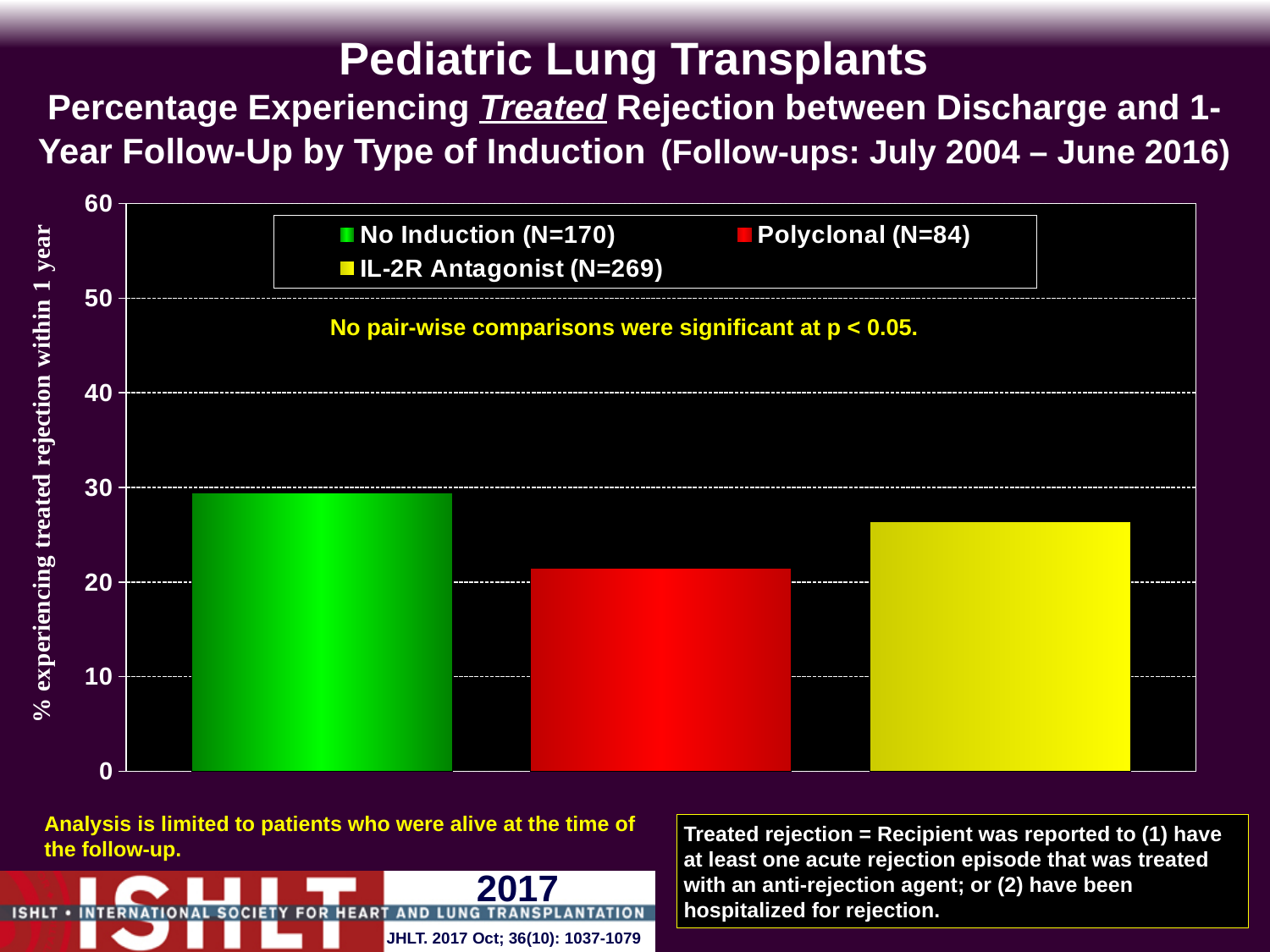
Which induction type has the lowest percentage experiencing treated rejection? Polyclonal How many series does the legend list? 3 Which is larger, the value for No Induction or the value for IL-2R Antagonist? No Induction What is the N shown in the legend for the Polyclonal group? 84 Which is larger, the value for Polyclonal or the value for IL-2R Antagonist? IL-2R Antagonist What colour is the bar for the Polyclonal group? red Which induction type has the highest percentage experiencing treated rejection? No Induction Is the value for Polyclonal greater or less than 20? greater Is the value for No Induction greater or less than 20? greater What kind of chart is shown on the slide? bar chart Is the value for IL-2R Antagonist greater or less than 30? less How many bars are plotted in the chart? 3